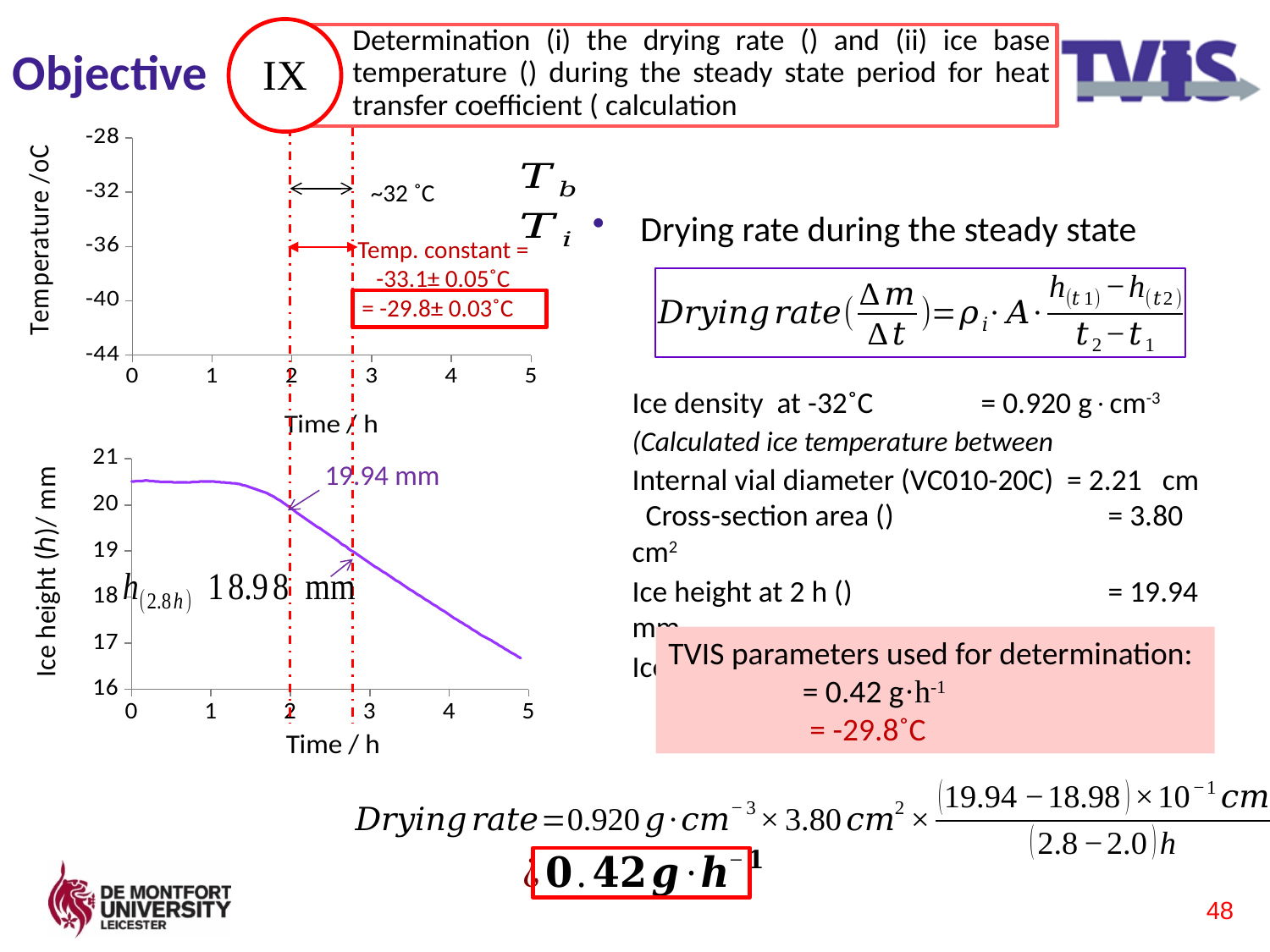
In the bottom chart (Ice height vs Time), does the ice height rise or fall as time increases? fall What kind of chart is the bottom chart (Ice height vs Time)? line chart In the bottom chart (Ice height vs Time), is the ice height at 1 h greater or less than 20 mm? greater In the bottom chart (Ice height vs Time), what is the difference between the labelled ice heights at 2 h and 2.8 h? 0.96 mm In the bottom chart (Ice height vs Time), what ice height is labelled at 2 h? 19.94 mm In the bottom chart (Ice height vs Time), what is the label of the y axis? Ice height (h)/ mm In the bottom chart (Ice height vs Time), what ice height is labelled at 2.8 h? 18.98 mm In the bottom chart (Ice height vs Time), which labelled value is larger, the ice height at 2 h or at 2.8 h? 2 h In the bottom chart (Ice height vs Time), is the ice height at 4 h greater or less than 18 mm? less In the top chart (Temperature vs Time), what is the lowest value shown on the y axis? -44 In the bottom chart (Ice height vs Time), how many tick marks are labelled on the x axis? 6 In the top chart (Temperature vs Time), what is the label of the y axis? Temperature /oC